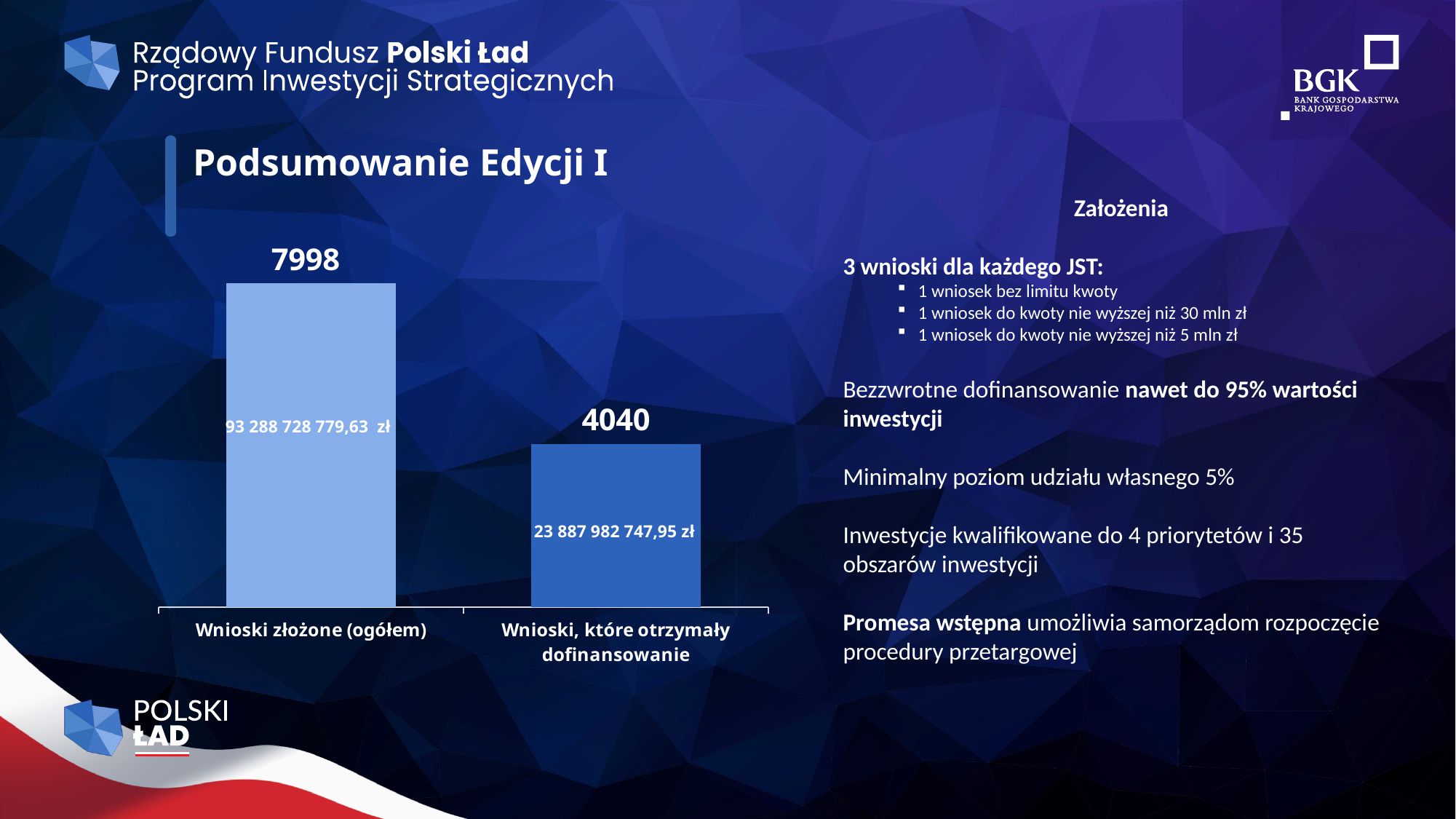
What is the value shown above the bar for "Wnioski złożone (ogółem)"? 7998 Which category has the lowest bar in the chart? Wnioski, które otrzymały dofinansowanie How many categories (bars) does the chart show? 2 What is the value shown above the bar for "Wnioski, które otrzymały dofinansowanie"? 4040 What is the title of the slide containing the chart? Podsumowanie Edycji I Which bar is drawn in the lighter shade of blue? Wnioski złożone (ogółem) What is the difference between the number of applications submitted (7998) and the number that received funding (4040)? 3958 Which is larger: the value for "Wnioski złożone (ogółem)" or the value for "Wnioski, które otrzymały dofinansowanie"? Wnioski złożone (ogółem) What amount in zł is printed inside the bar for "Wnioski złożone (ogółem)"? 93 288 728 779,63 zł What amount in zł is printed inside the bar for "Wnioski, które otrzymały dofinansowanie"? 23 887 982 747,95 zł Which category has the highest bar in the chart? Wnioski złożone (ogółem) What kind of chart is shown on the slide? Bar chart